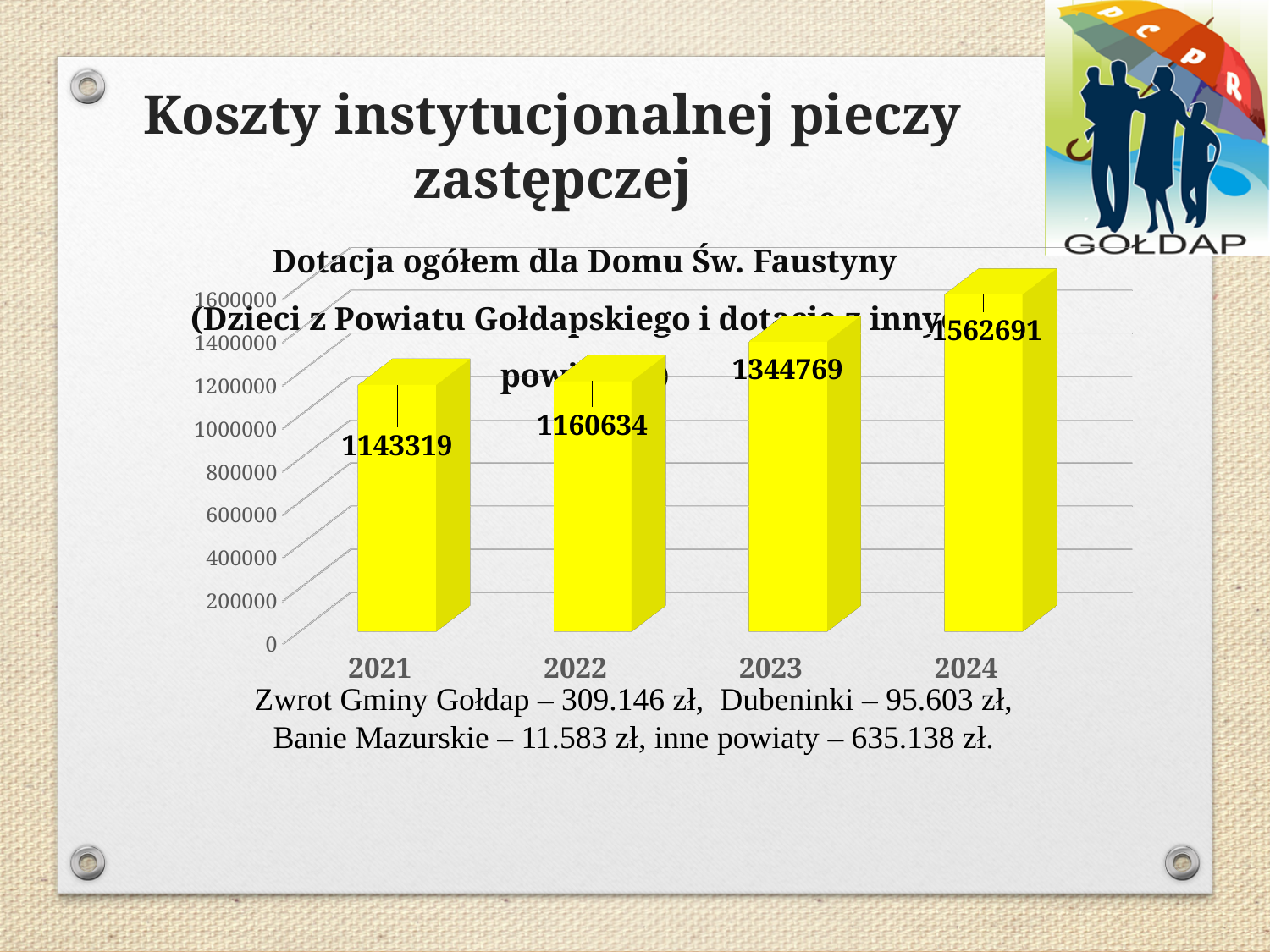
What is the value for 2021? 1143319 Do the values rise or fall from 2021 to 2024? rise Which year has the lowest value? 2021 What is the value for 2024? 1562691 What is the value for 2023? 1344769 Is the value for 2024 greater or less than 1400000? greater Which year has the highest value? 2024 How many years are shown on the x axis? 4 Which is larger, the value for 2023 or the value for 2022? 2023 What is the difference between the values for 2024 and 2023? 217922 What is the difference between the values for 2024 and 2021? 419372 What is the value for 2022? 1160634